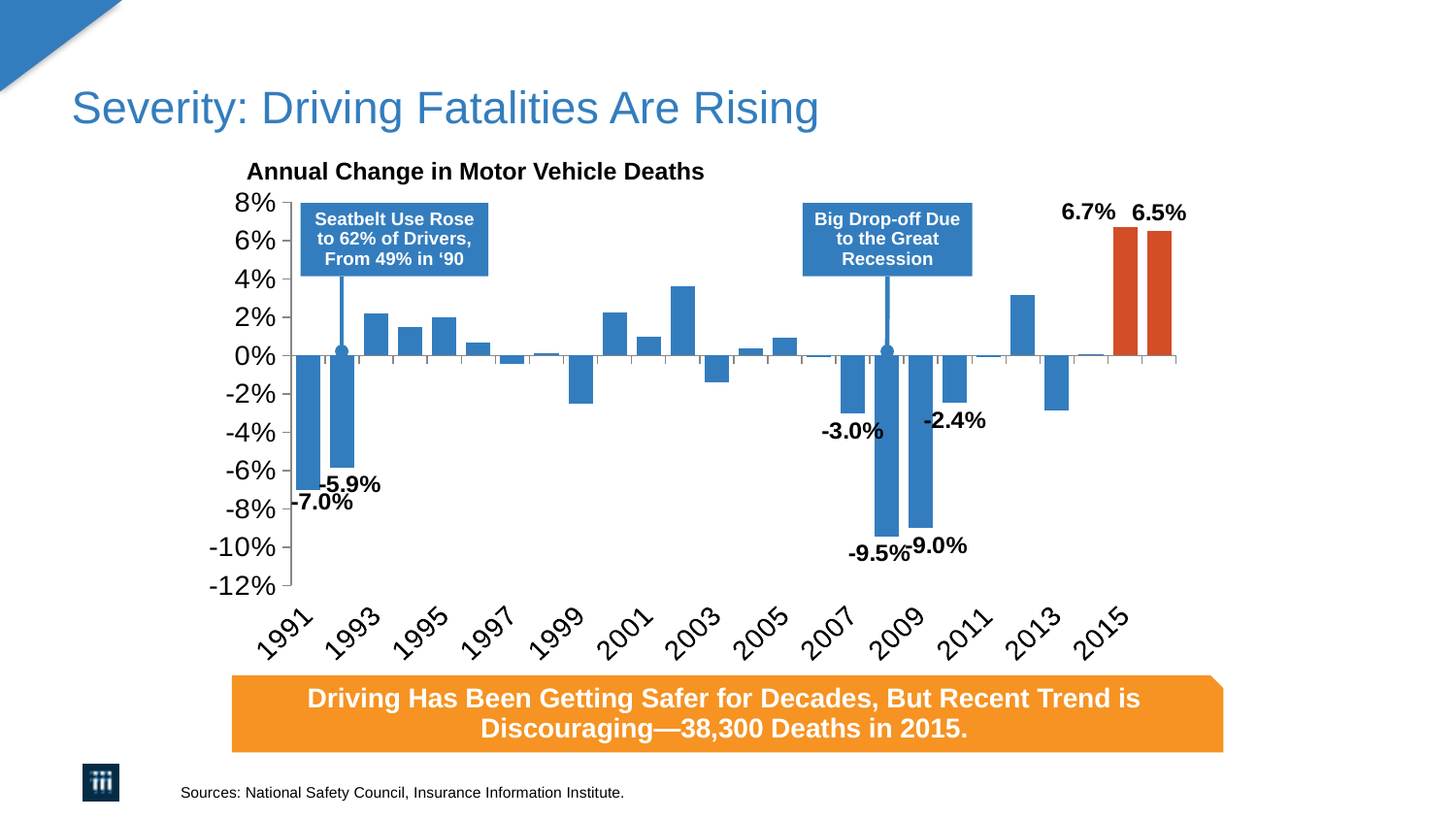
What is the value of the lowest bar on the chart? -9.5% What kind of chart is shown on the slide? bar chart What is the highest value labeled on the chart? 6.7% According to the callout on the chart, seatbelt use rose to what percentage of drivers? 62% What is the difference between the two orange bars, 6.7% and 6.5%? 0.2 percentage points What is the value of the second bar (1992) in the chart? -5.9% What is the difference between the 1991 value (-7.0%) and the 1992 value (-5.9%)? 1.1 percentage points What is the title of the chart? Annual Change in Motor Vehicle Deaths How many bars have printed data labels on the chart? 8 What is the annual change in motor vehicle deaths for 1991? -7.0% Which is lower, the bar labeled -9.5% or the bar labeled -9.0%? -9.5% Is the value for 1991 greater or less than -6%? less